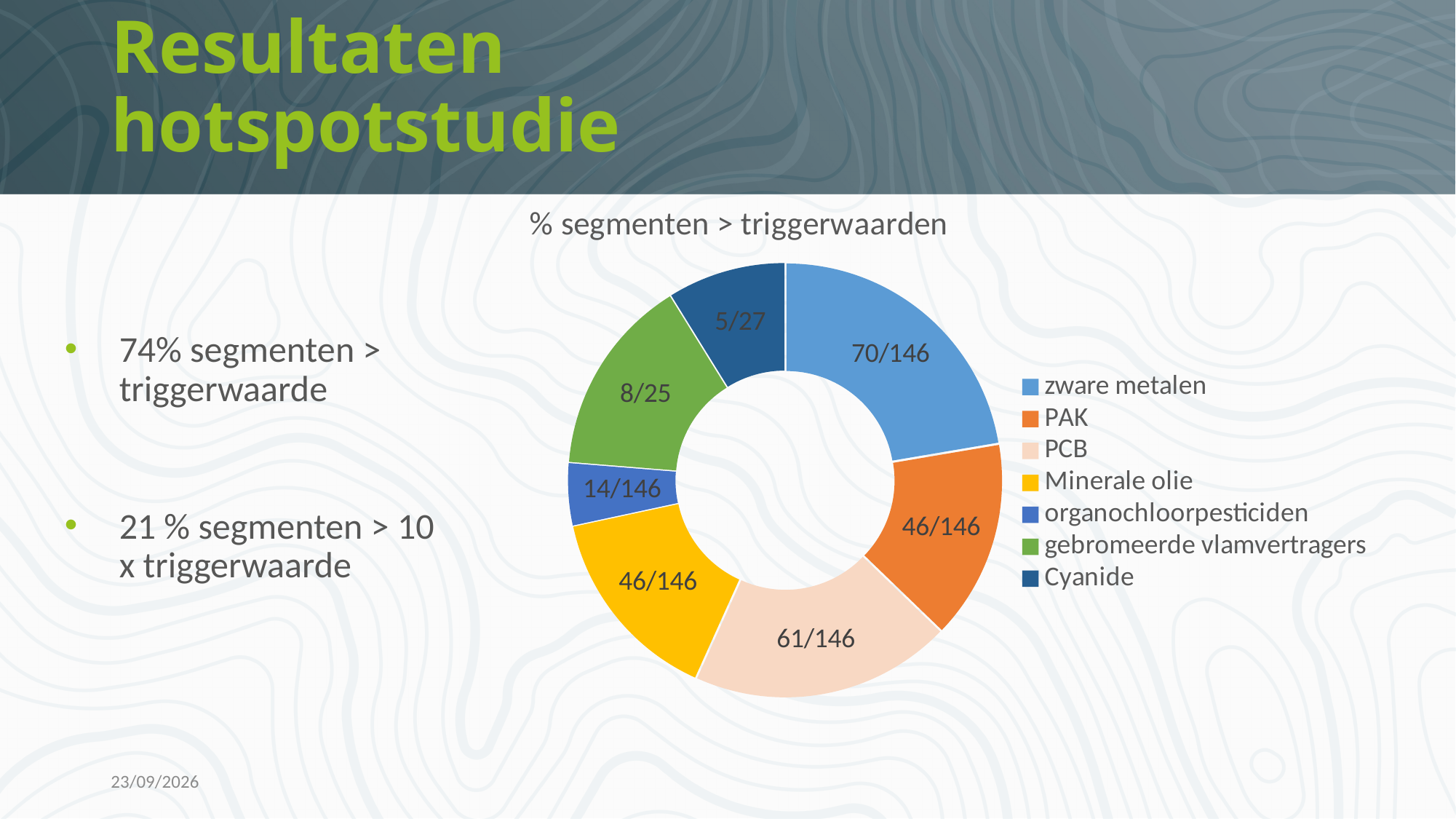
What type of chart is shown on the slide? Doughnut (pie) chart What is the title of the chart? % segmenten > triggerwaarden Which category has the largest slice in the chart? zware metalen Which category has the smallest slice in the chart? organochloorpesticiden What is the data label shown for organochloorpesticiden? 14/146 What is the data label shown for zware metalen? 70/146 What is the data label shown for Cyanide? 5/27 Which slice is larger, PCB or PAK? PCB What is the data label shown for PAK? 46/146 What is the data label shown for gebromeerde vlamvertragers? 8/25 How many categories does the legend list? 7 What is the data label shown for PCB? 61/146